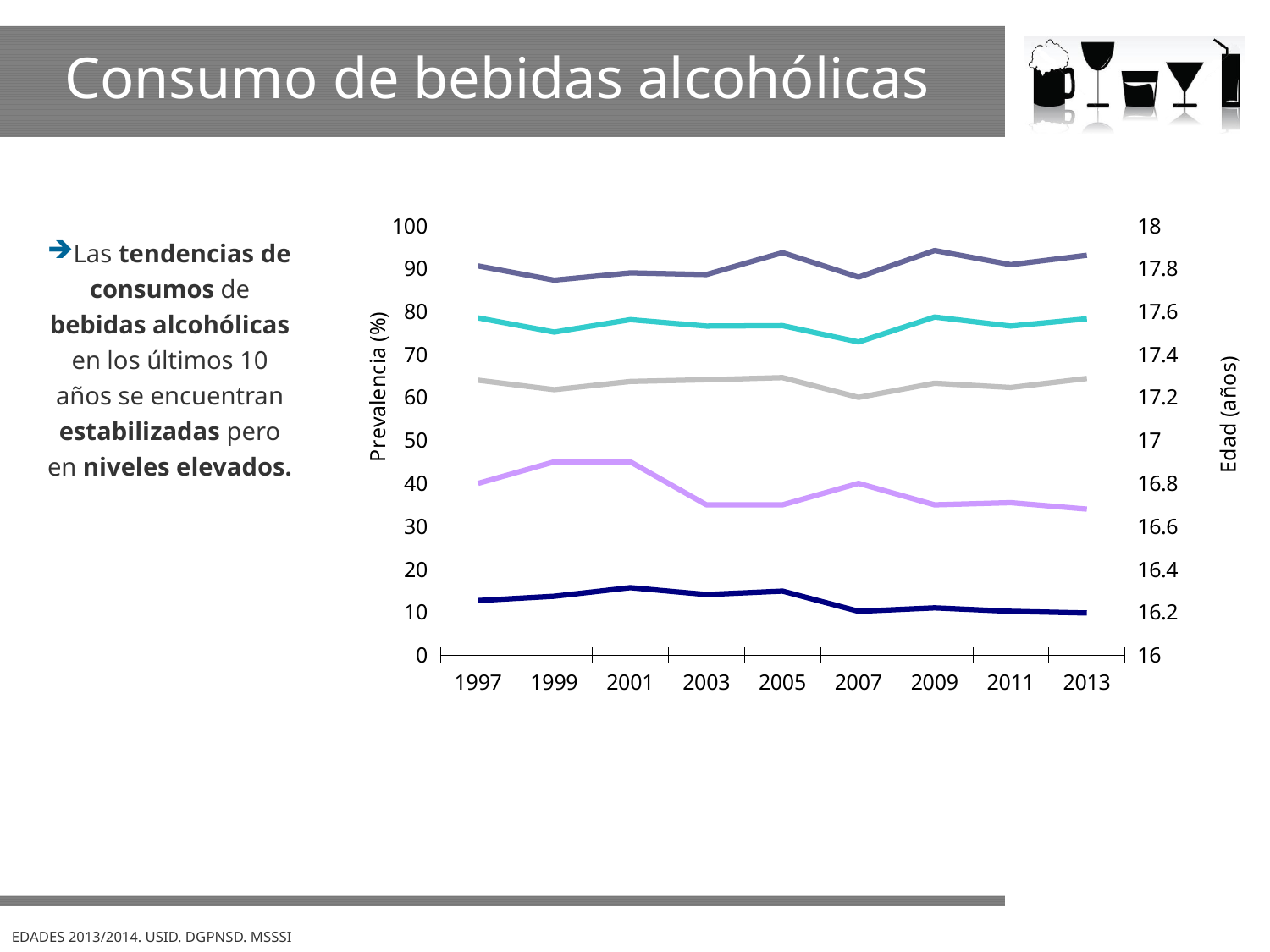
What is the first year shown on the x axis? 1997 What kind of chart is shown on the slide? line chart What is the title of the left vertical axis? Prevalencia (%) How many lines are plotted in the chart? 5 Is the grey line above or below the light purple line in every year? above Does the light purple line rise or fall between 2001 and 2003? fall Which line is the highest across all years: the dark purple line or the teal line? the dark purple line What is the title of the right vertical axis? Edad (años) How many years are marked along the x axis of the chart? 9 What is the last year shown on the x axis? 2013 Does the dark purple line rise or fall between 2007 and 2009? rise Does the dark navy line at the bottom rise or fall between 2005 and 2007? fall